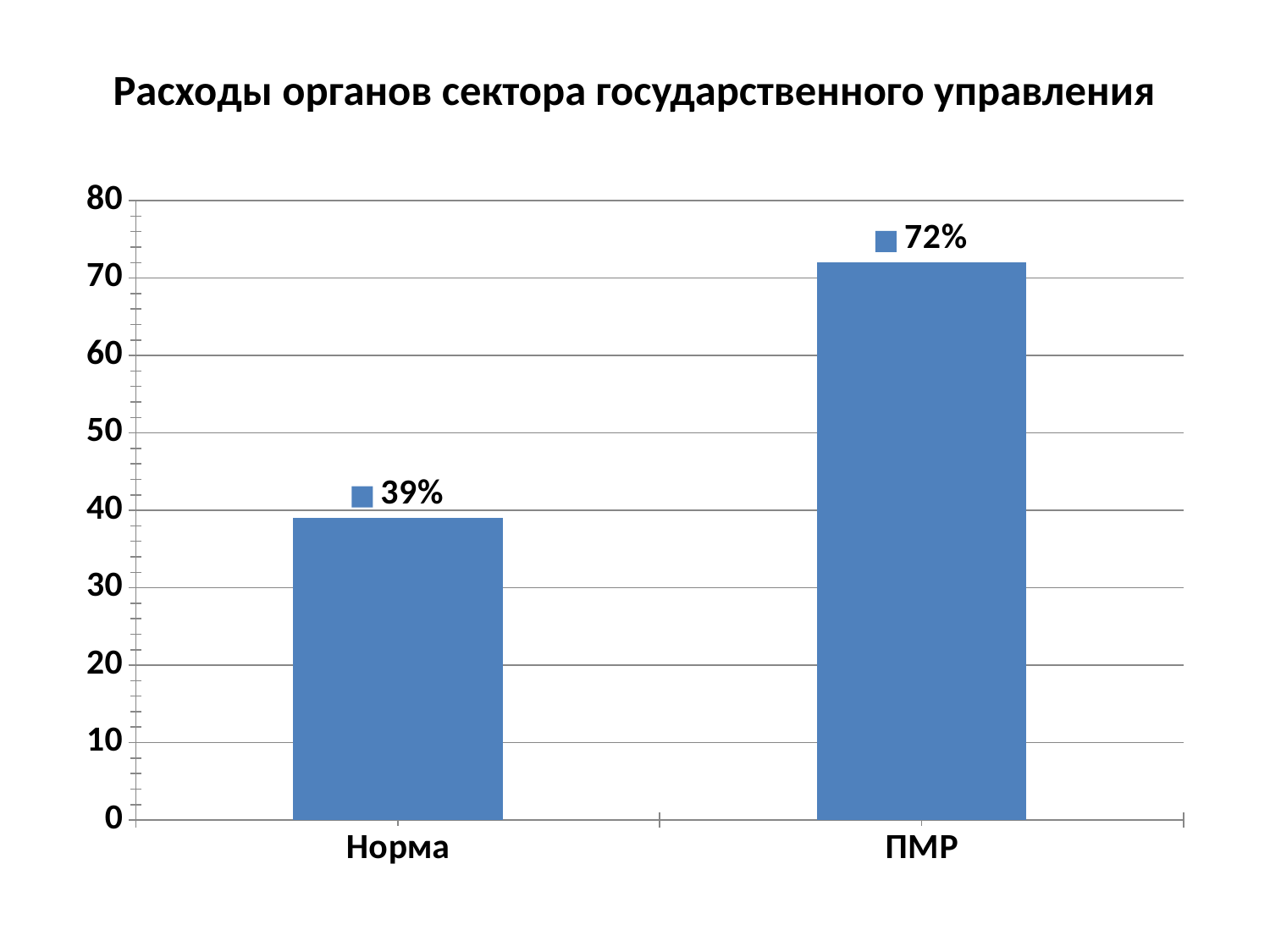
What is the maximum value shown on the vertical axis? 80 Is the value for Норма greater or less than 40? less Is the value for ПМР greater or less than 70? greater What is the value for ПМР? 72% Which category has the highest value? ПМР Which category has the lowest value? Норма What kind of chart is shown on the slide? bar chart What is the value for Норма? 39% What is the difference between the values for ПМР and Норма? 33% What is the title of the chart? Расходы органов сектора государственного управления Which is larger, the value for Норма or the value for ПМР? ПМР How many categories are shown on the x axis? 2